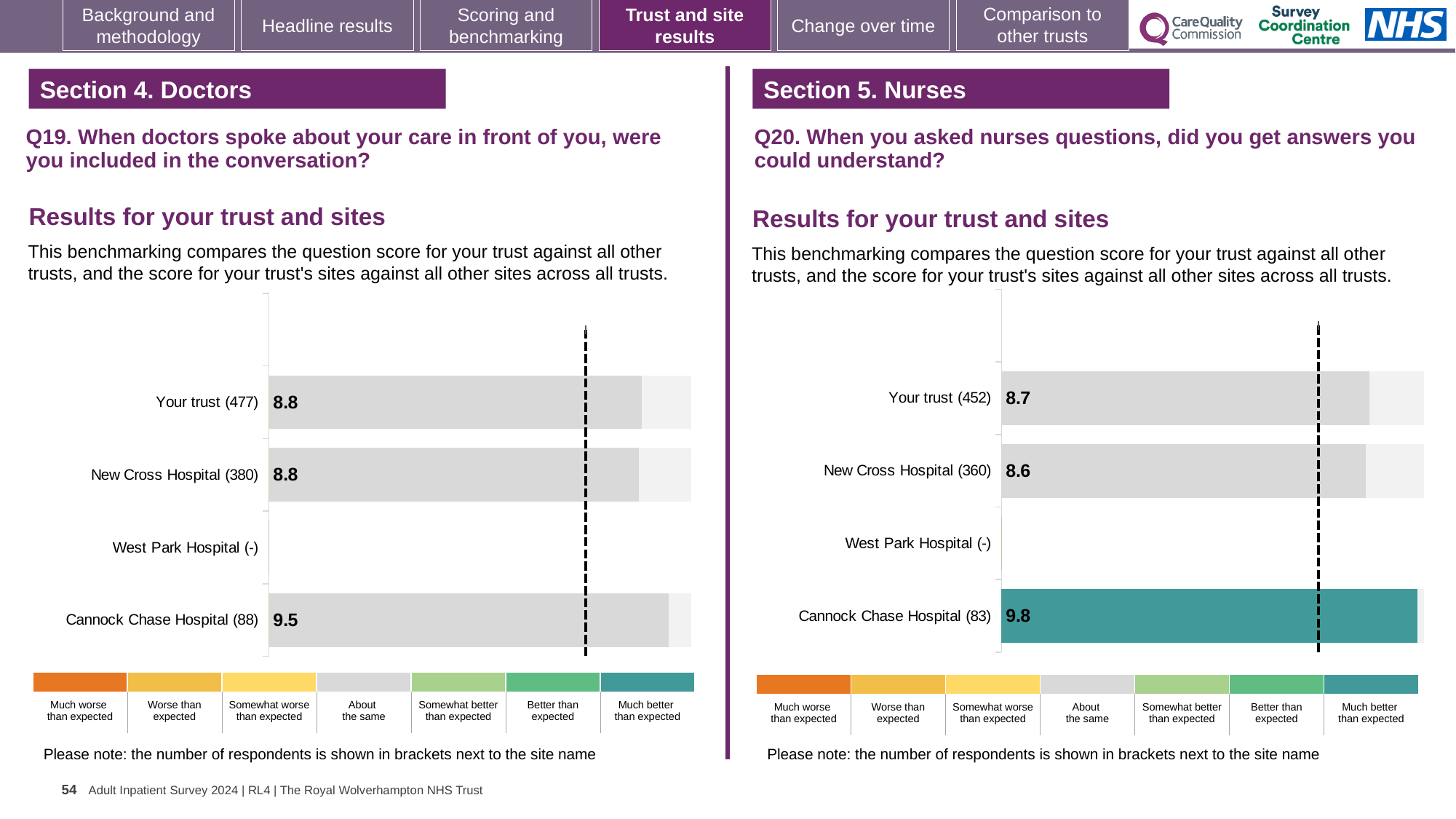
In the Q20 chart on the right, which benchmark category does the colour of the Cannock Chase Hospital (83) bar correspond to? Much better than expected In the Q19 chart on the left, what is the score for Your trust (477)? 8.8 In the Q19 chart on the left, which site has the highest score? Cannock Chase Hospital (88) In the Q20 chart on the right, what is the score for Cannock Chase Hospital (83)? 9.8 In the Q20 chart on the right, what is the difference between the scores for Cannock Chase Hospital (83) and Your trust (452)? 1.1 In the Q20 chart on the right, what is the score for New Cross Hospital (360)? 8.6 How many site/trust categories are listed on the y axis of the Q19 chart on the left? 4 In the Q19 chart on the left, what is the score for Cannock Chase Hospital (88)? 9.5 In the Q20 chart on the right, which site has the highest score? Cannock Chase Hospital (83) In the Q19 chart on the left, what is the difference between the scores for Cannock Chase Hospital (88) and New Cross Hospital (380)? 0.7 What type of chart is used for the Q20 results on the right? Bar chart In the Q20 chart on the right, which has the larger score, Your trust (452) or New Cross Hospital (360)? Your trust (452)